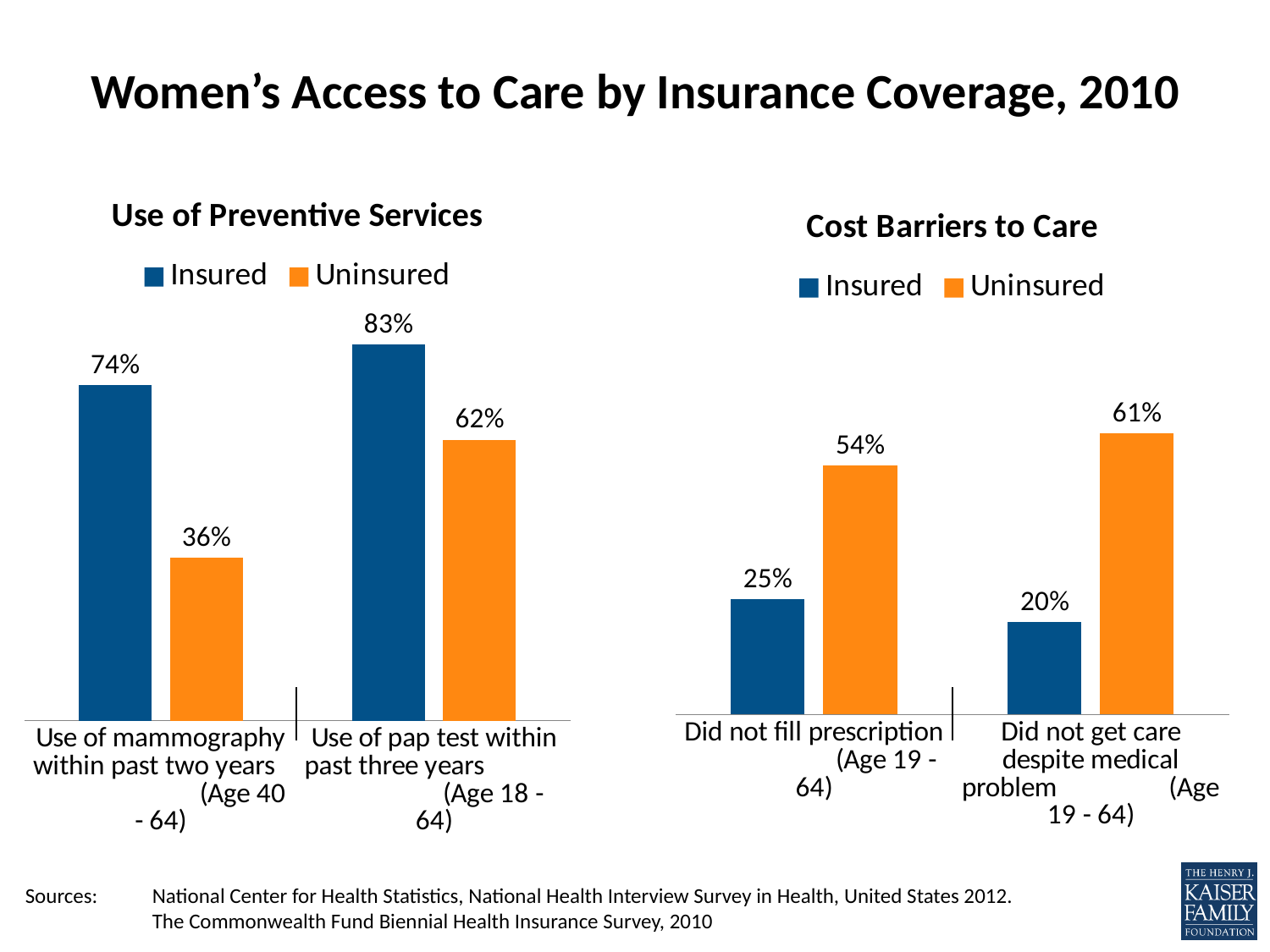
In the 'Cost Barriers to Care' chart, which is larger for did not fill prescription: Insured or Uninsured? Uninsured In the 'Use of Preventive Services' chart, which bar has the highest value? Insured, use of pap test within past three years (83%) What type of chart is the 'Cost Barriers to Care' chart? Bar chart How many series does the legend of the 'Use of Preventive Services' chart list? 2 In the 'Cost Barriers to Care' chart, what is the value for Insured women who did not get care despite a medical problem? 20% In the 'Use of Preventive Services' chart, what is the difference between Insured and Uninsured values for use of mammography within past two years? 38 percentage points In the 'Cost Barriers to Care' chart, what is the difference between Uninsured and Insured values for did not get care despite medical problem? 41 percentage points In the 'Use of Preventive Services' chart, what is the value for Insured women for use of mammography within past two years? 74% In the 'Cost Barriers to Care' chart, what is the value for Uninsured women who did not fill a prescription? 54% In the 'Cost Barriers to Care' chart, which bar has the lowest value? Insured, did not get care despite medical problem (20%) In the 'Use of Preventive Services' chart, what is the value for Uninsured women for use of pap test within past three years? 62% How many categories are shown on the x axis of the 'Cost Barriers to Care' chart? 2